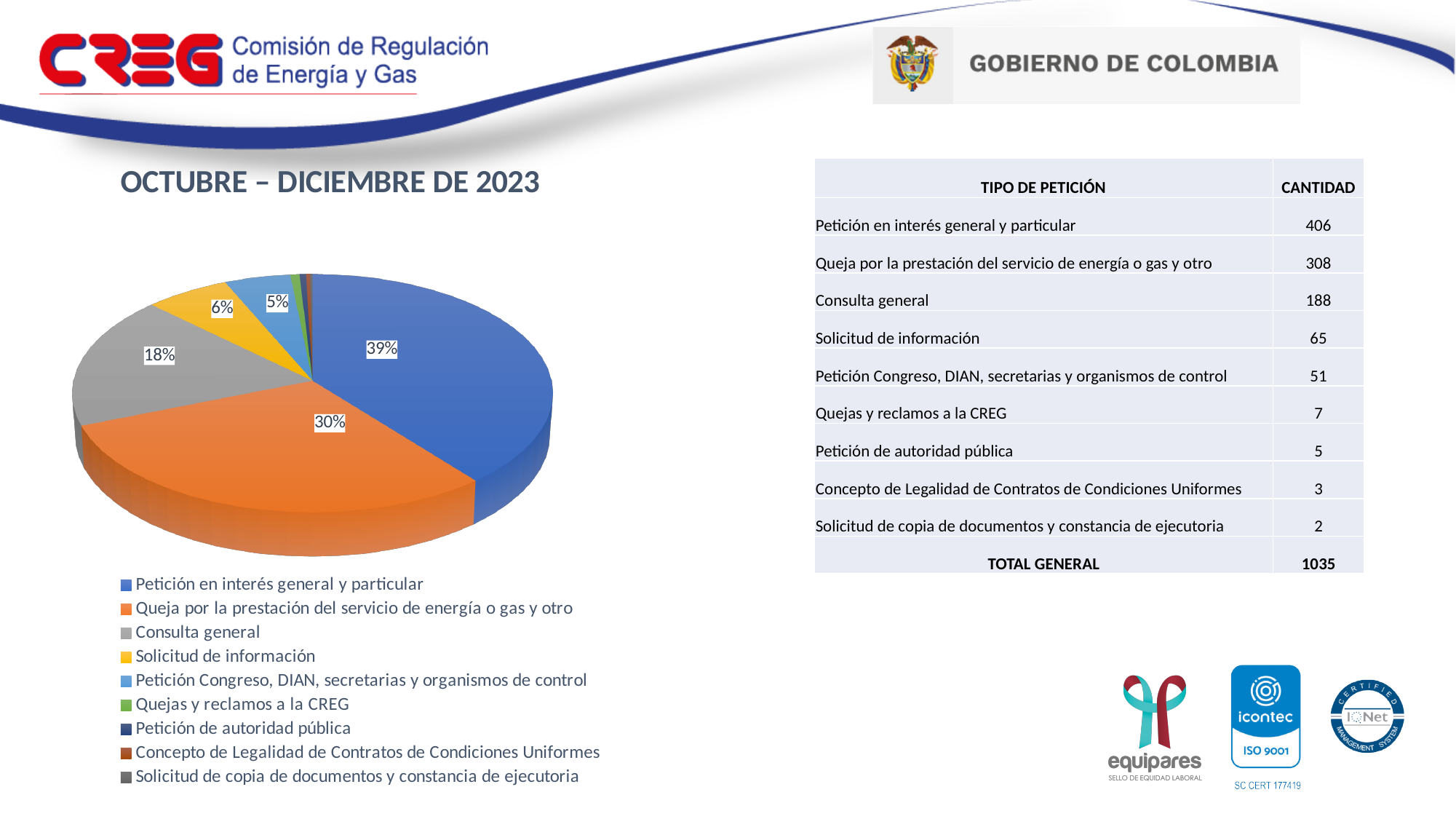
How many categories does the pie chart's legend list? 9 What share of the pie does "Consulta general" represent? 18% What share of the pie does "Queja por la prestación del servicio de energía o gas y otro" represent? 30% What share of the pie does "Petición Congreso, DIAN, secretarias y organismos de control" represent? 5% What is the difference in percentage points between the "Petición en interés general y particular" slice and the "Queja por la prestación del servicio de energía o gas y otro" slice? 9 percentage points Which slice is larger: "Consulta general" or "Solicitud de información"? Consulta general What period does the heading above the pie chart refer to? OCTUBRE – DICIEMBRE DE 2023 Which category has the largest slice of the pie? Petición en interés general y particular What kind of chart is shown on the slide? pie chart What colour is the slice for "Queja por la prestación del servicio de energía o gas y otro"? orange